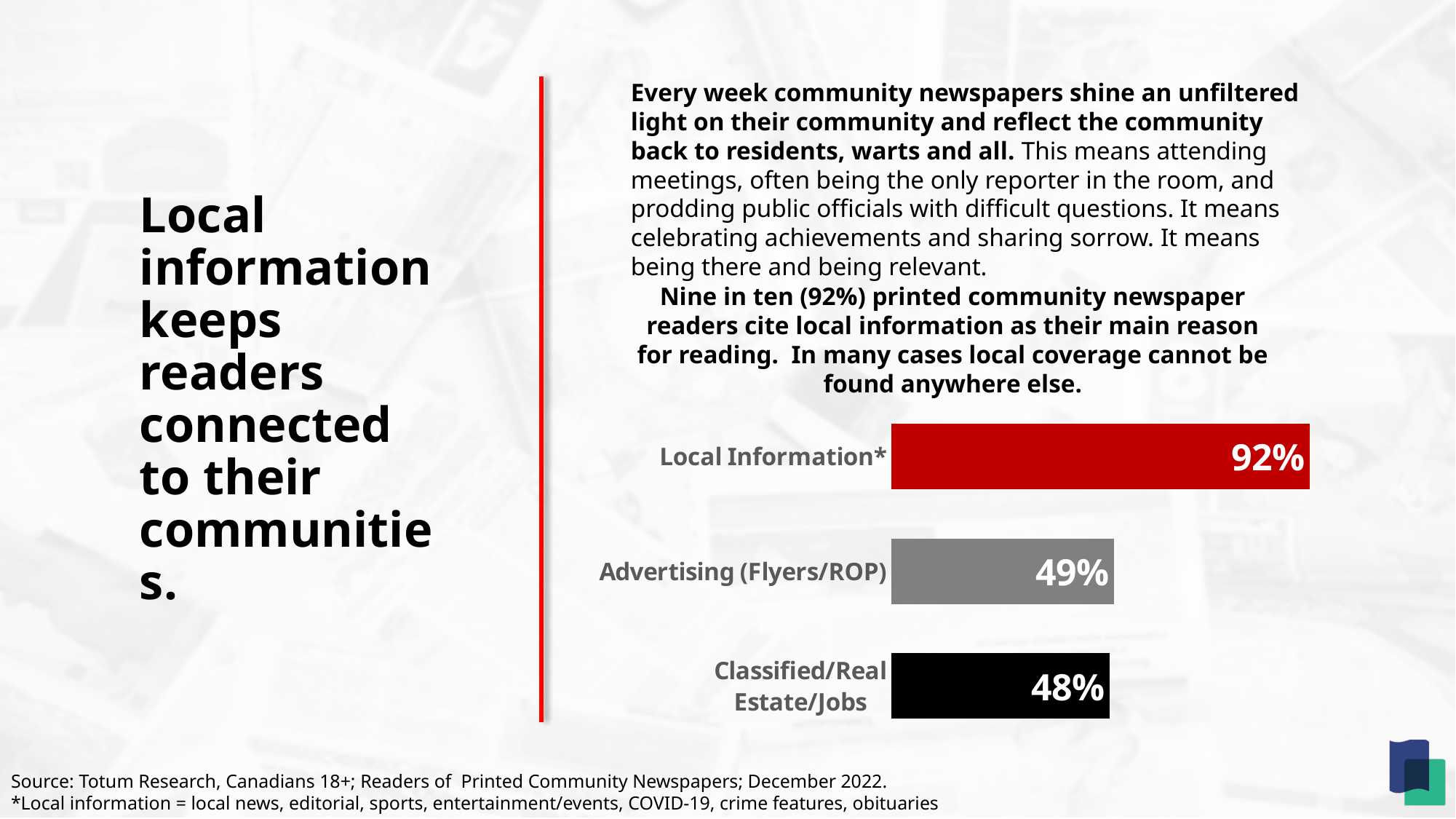
Which category has the highest value? Local Information* What kind of chart is shown on the slide? Bar chart Which category has the lowest value? Classified/Real Estate/Jobs What colour is the bar for Classified/Real Estate/Jobs? Black How many categories are shown in the chart? 3 What is the difference between the values for Advertising (Flyers/ROP) and Classified/Real Estate/Jobs? 1% Which is larger, the value for Local Information* or the value for Classified/Real Estate/Jobs? Local Information* What is the value for Local Information*? 92% What is the value for Classified/Real Estate/Jobs? 48% What is the value for Advertising (Flyers/ROP)? 49% What is the difference between the values for Local Information* and Advertising (Flyers/ROP)? 43% What colour is the bar for Local Information*? Red